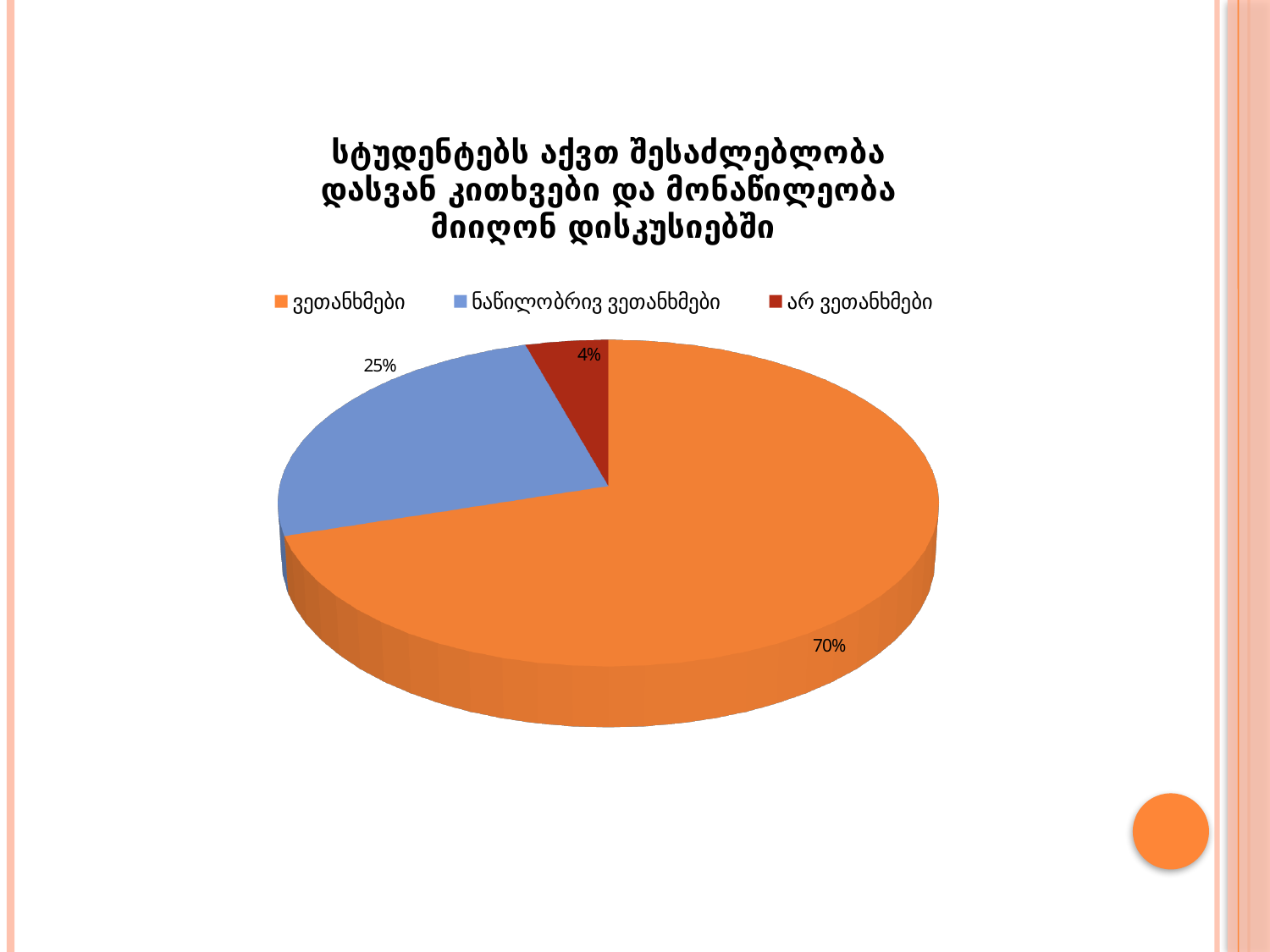
Which category has the smallest share of the pie? არ ვეთანხმები Which is larger, the share for ნაწილობრივ ვეთანხმები or the share for არ ვეთანხმები? ნაწილობრივ ვეთანხმები What kind of chart is shown on the slide? Pie chart How many slices does the pie chart have? 3 What is the difference in percentage points between ვეთანხმები and ნაწილობრივ ვეთანხმები? 45 What is the difference in percentage points between ნაწილობრივ ვეთანხმები and არ ვეთანხმები? 21 How many entries does the legend list? 3 What percentage of the pie is labelled for ნაწილობრივ ვეთანხმები? 25% What percentage of the pie is labelled for არ ვეთანხმები? 4% Which category has the largest share of the pie? ვეთანხმები What colour is the slice for არ ვეთანხმები? Dark red What percentage of the pie is labelled for ვეთანხმები? 70%